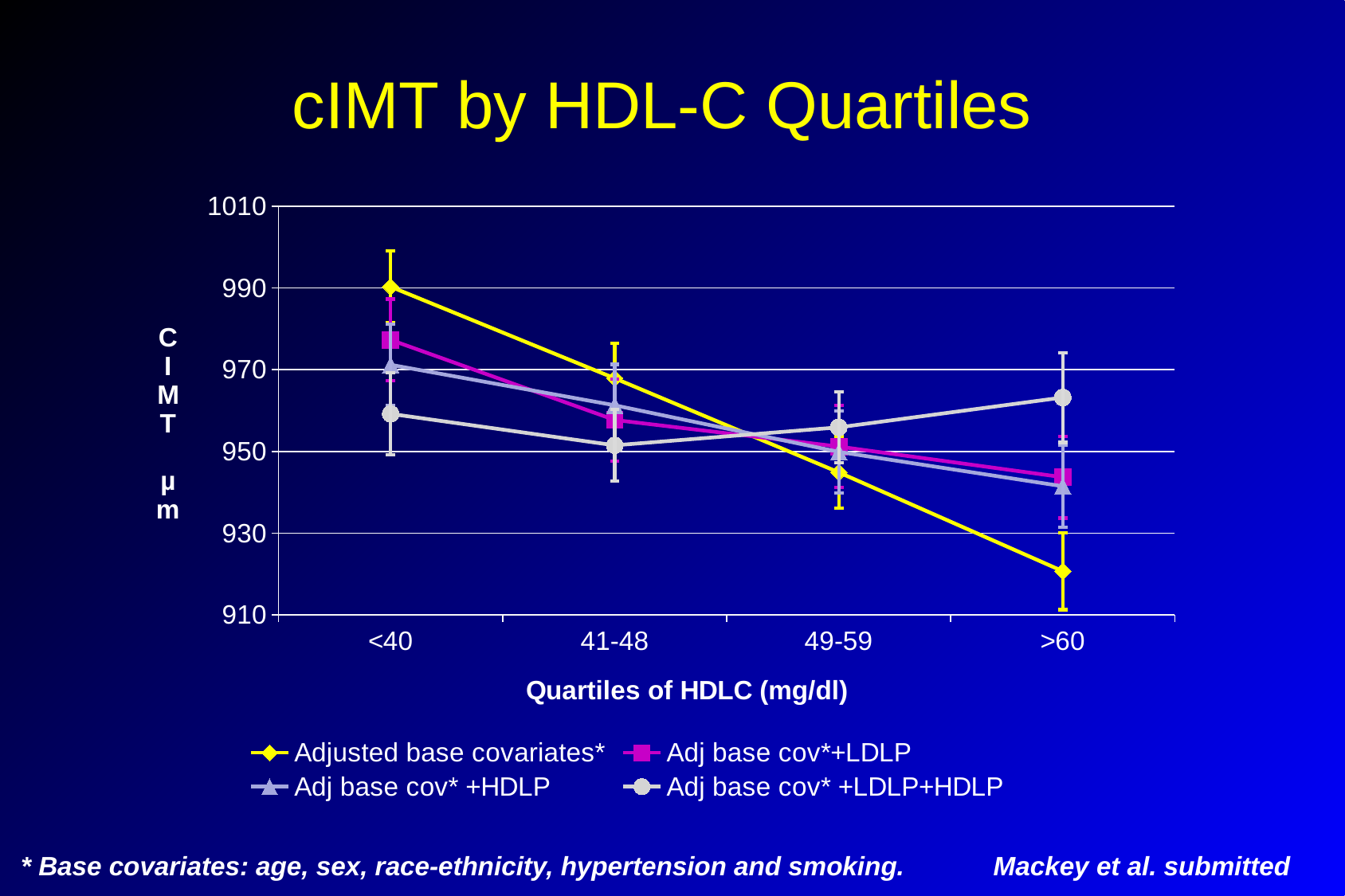
At the <40 quartile, which is larger: Adjusted base covariates* or Adj base cov* +HDLP? Adjusted base covariates* How many series does the legend list? 4 What kind of chart is shown on the slide? line chart Does the Adjusted base covariates* series rise or fall from the <40 quartile to the >60 quartile? fall How many HDL-C quartile categories are shown on the x axis? 4 At the >60 quartile, which is larger: Adjusted base covariates* or Adj base cov* +LDLP+HDLP? Adj base cov* +LDLP+HDLP Is the value for Adjusted base covariates* at the <40 quartile greater or less than 970? greater Is the value for Adjusted base covariates* at the >60 quartile greater or less than 930? less What is the title of the x axis? Quartiles of HDLC (mg/dl) Does the Adj base cov*+LDLP series rise or fall across the quartiles from <40 to >60? fall Which quartile has the lowest value for the Adjusted base covariates* series? >60 Is the value for Adj base cov* +LDLP+HDLP at the <40 quartile greater or less than 970? less